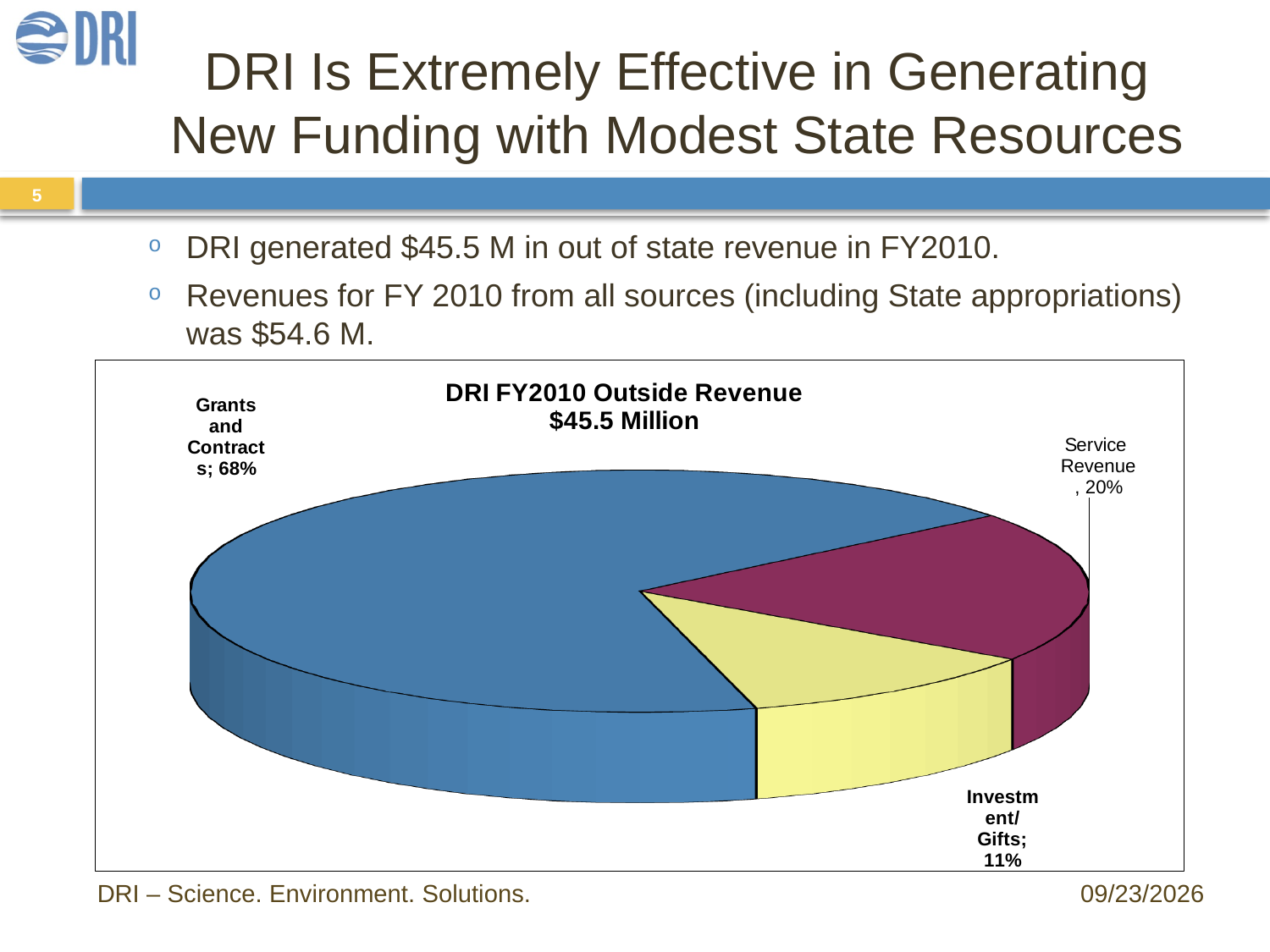
What is the difference in percentage points between Grants and Contracts and Service Revenue? 48 What share of the pie is Grants and Contracts? 68% Which category has the largest slice of the pie? Grants and Contracts What is the difference in percentage points between Service Revenue and Investment/Gifts? 9 What kind of chart is shown on the slide? pie chart Which category has the smallest slice of the pie? Investment/Gifts What colour is the Grants and Contracts slice? blue What share of the pie is Service Revenue? 20% How many slices does the pie chart have? 3 Which is larger, the Service Revenue slice or the Investment/Gifts slice? Service Revenue What share of the pie is Investment/Gifts? 11% What is the title of the chart? DRI FY2010 Outside Revenue $45.5 Million